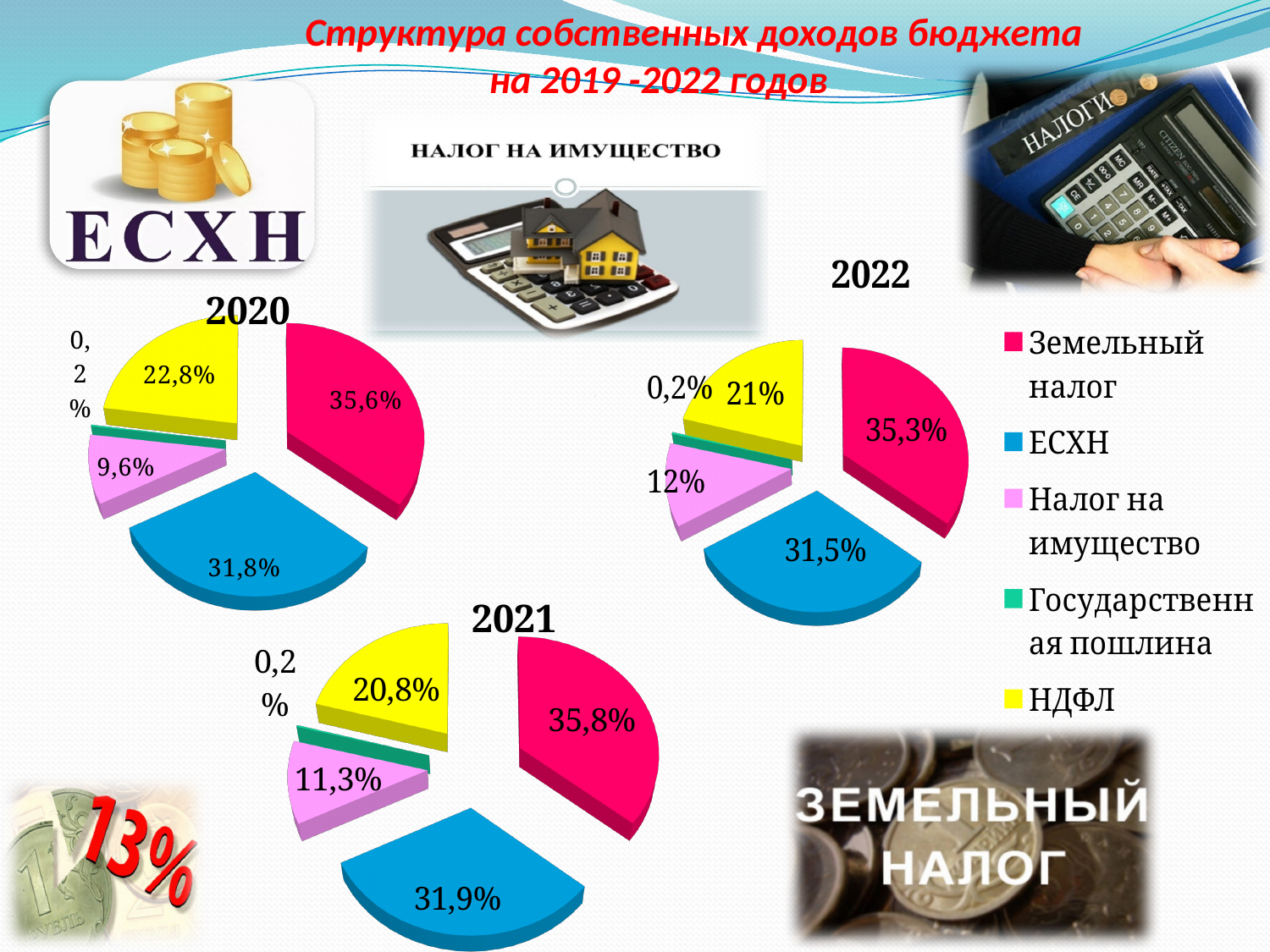
In the 2021 pie chart, what is the value for Налог на имущество? 11,3% Which colour represents Налог на имущество in the legend? Pink In the 2020 pie chart, which category has the largest share? Земельный налог Which is larger in the 2021 pie chart: the share of ЕСХН or the share of НДФЛ? ЕСХН In the 2022 pie chart, what is the value for ЕСХН? 31,5% In the 2020 pie chart, what share does Земельный налог have? 35,6% What kind of charts are shown on the slide? Pie charts In the 2022 pie chart, what is the value for НДФЛ? 21% In the 2020 pie chart, what is the difference between the shares of НДФЛ and Налог на имущество? 13,2% In the 2021 pie chart, which category has the smallest share? Государственная пошлина In the 2022 pie chart, what is the difference between the shares of Земельный налог and ЕСХН? 3,8% How many series does the legend list? 5